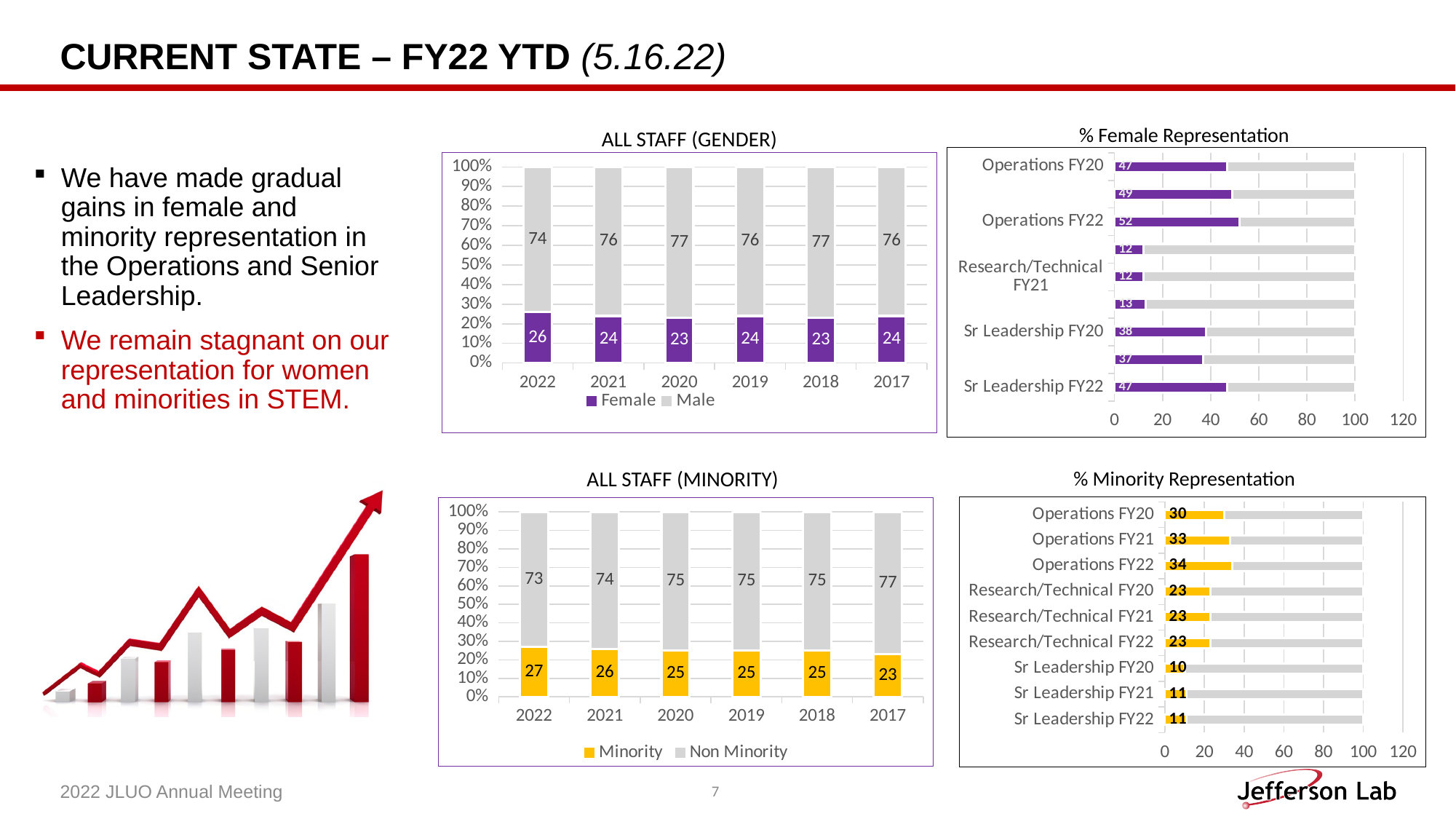
In the ALL STAFF (MINORITY) chart, how many years are shown on the x axis? 6 In the % Minority Representation chart, which category has the lowest value? Sr Leadership FY20 In the ALL STAFF (MINORITY) chart, what is the difference between the Minority values for 2022 and 2017? 4 In the % Minority Representation chart, is the value for Operations FY20 larger or smaller than the value for Research/Technical FY20? larger In the ALL STAFF (GENDER) chart, which year has the highest Female value? 2022 In the ALL STAFF (GENDER) chart, what is the Male value for 2020? 77 In the ALL STAFF (MINORITY) chart, what is the Minority value for 2017? 23 In the % Female Representation chart, what is the value for Operations FY22? 52 In the ALL STAFF (GENDER) chart, what is the Female value for 2022? 26 In the ALL STAFF (MINORITY) chart, what is the total of the stacked bar for 2019? 100 In the % Minority Representation chart, what is the value for Operations FY22? 34 In the ALL STAFF (GENDER) chart, how many series does the legend list? 2